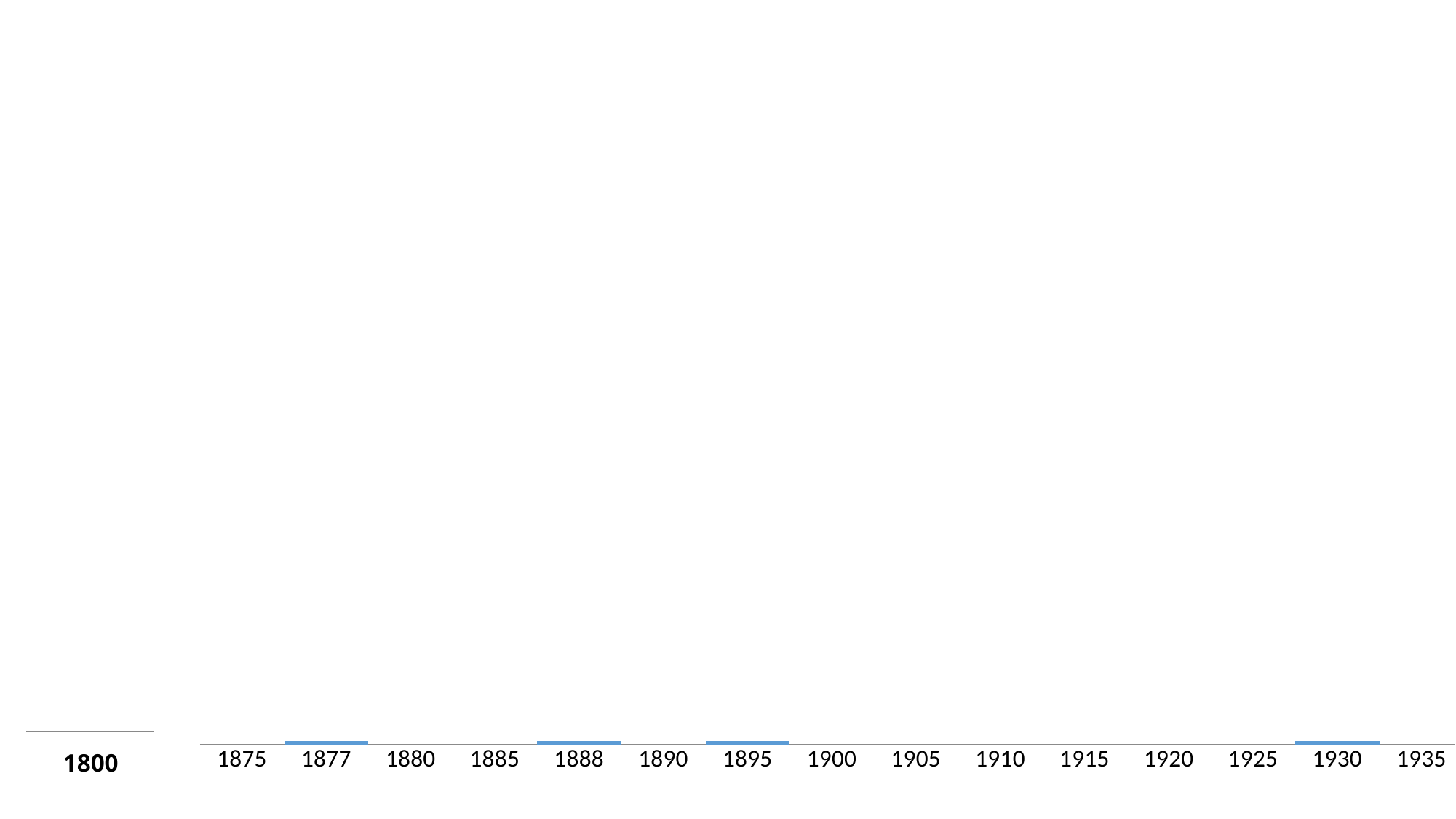
What is the last year label shown on the x axis? 1935 What is the first year label shown on the x axis after the bold 1800? 1875 How many year labels are shown along the x axis of the chart (excluding the bold 1800 at the left)? 15 Which years on the x axis have a blue marker above them? 1877, 1888, 1895, 1930 How many blue markers are highlighted along the x axis of the chart? 4